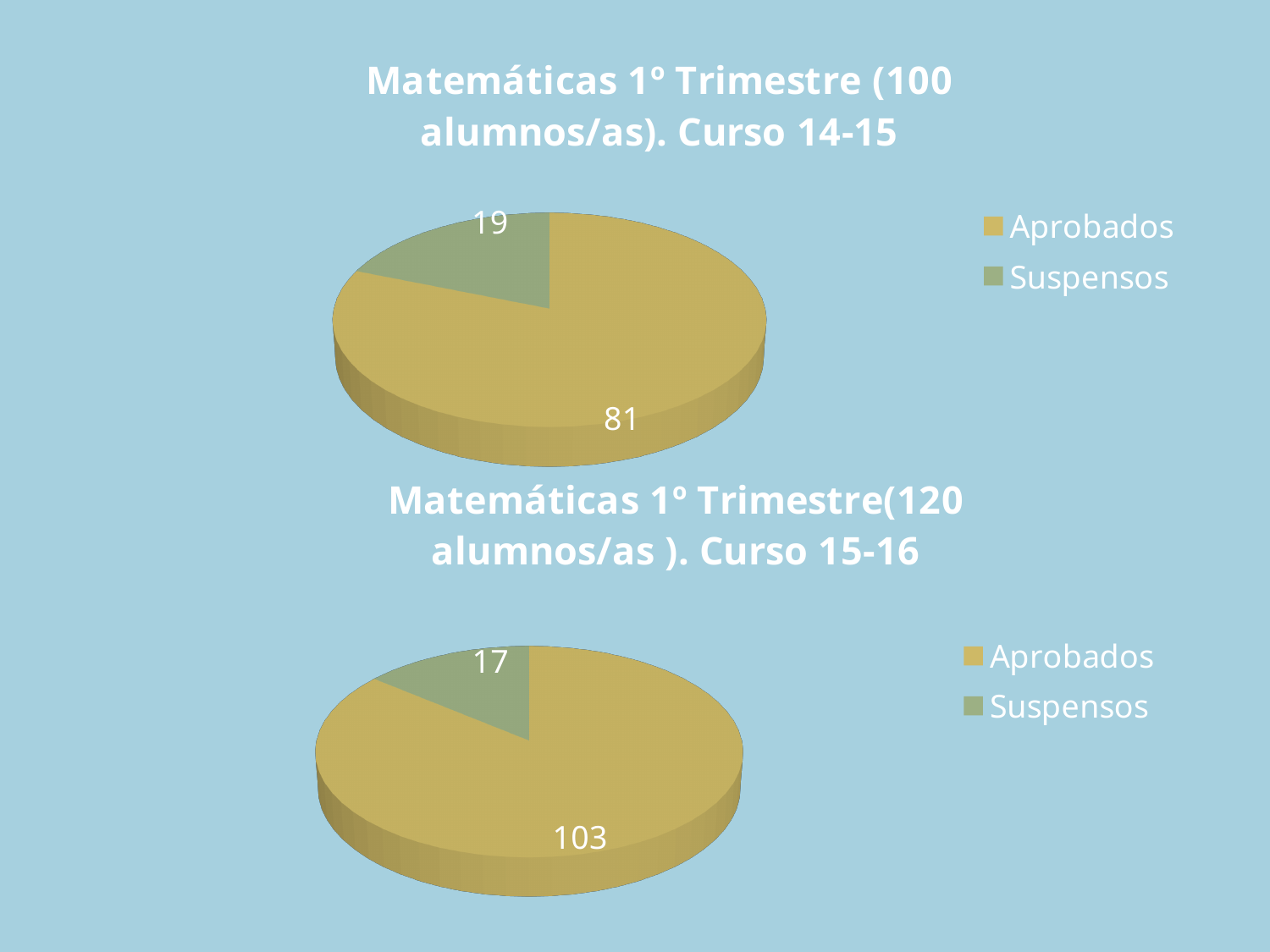
In the top chart (Curso 14-15), what is the value for Suspensos? 19 How many categories does the bottom chart (Curso 15-16) show? 2 In the bottom chart (Curso 15-16), what is the value for Suspensos? 17 What type of chart is the top chart (Curso 14-15)? Pie chart In the top chart (Curso 14-15), what is the value for Aprobados? 81 Which is larger: Suspensos in the top chart (Curso 14-15) or Suspensos in the bottom chart (Curso 15-16)? Suspensos in the top chart (Curso 14-15) In the bottom chart (Curso 15-16), which category has the smallest slice? Suspensos In the bottom chart (Curso 15-16), what is the difference between Aprobados and Suspensos? 86 In the bottom chart (Curso 15-16), what is the value for Aprobados? 103 In the top chart (Curso 14-15), which category has the largest slice? Aprobados In the top chart (Curso 14-15), what is the difference between Aprobados and Suspensos? 62 What is the title of the bottom chart? Matemáticas 1º Trimestre(120 alumnos/as ). Curso 15-16